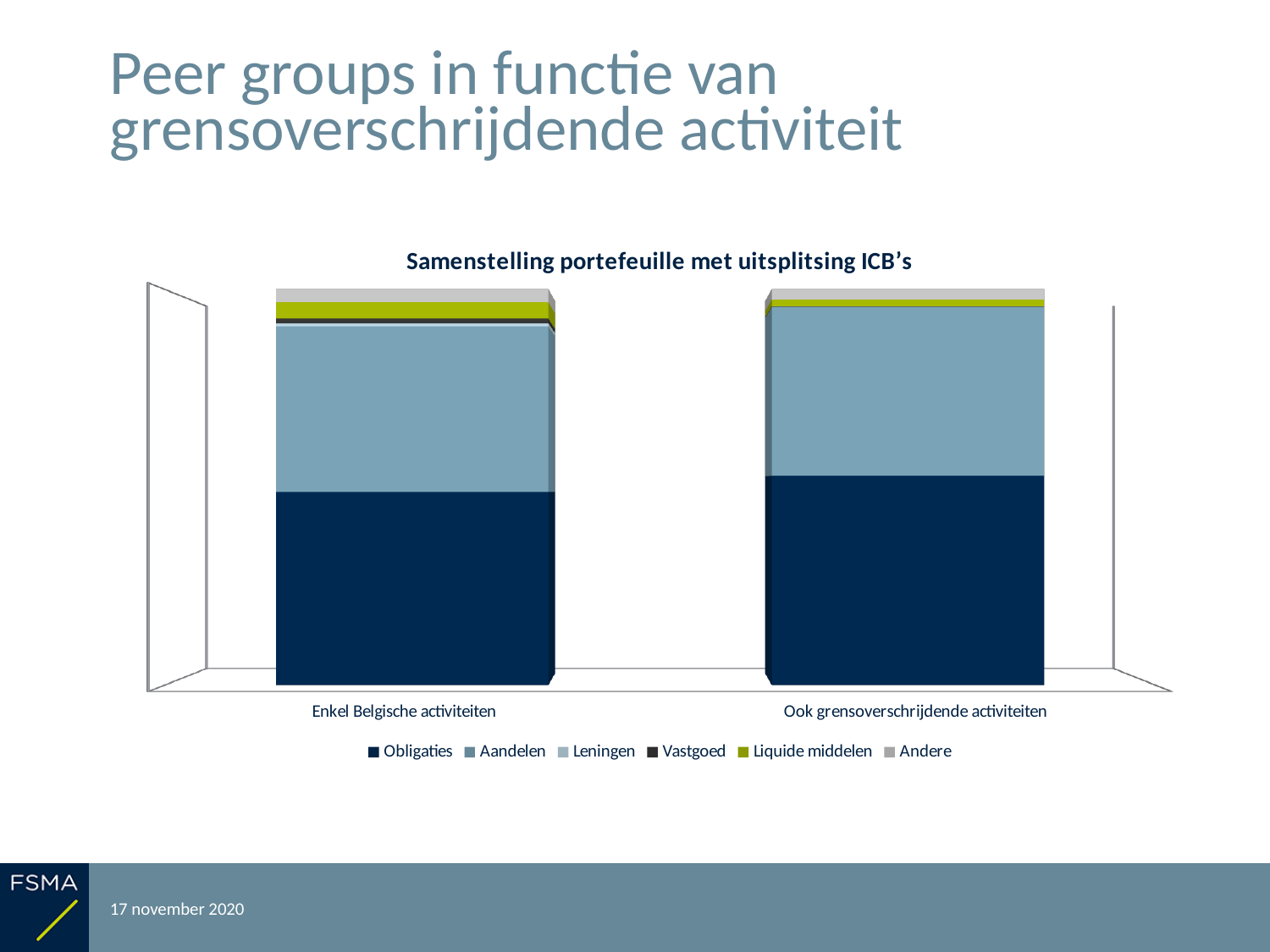
Which series makes up the largest segment of the 'Ook grensoverschrijdende activiteiten' bar? Obligaties Which bar has the larger Liquide middelen segment: 'Enkel Belgische activiteiten' or 'Ook grensoverschrijdende activiteiten'? Enkel Belgische activiteiten What is the label of the right-hand bar on the x axis? Ook grensoverschrijdende activiteiten Which series is the second-largest segment in the 'Enkel Belgische activiteiten' bar? Aandelen Which series is listed first in the chart legend? Obligaties How many categories (bars) are shown on the x axis of the chart? 2 How many series does the chart legend list? 6 What kind of chart is shown on the slide? Stacked bar chart What is the title of the chart? Samenstelling portefeuille met uitsplitsing ICB's Which bar has the larger Obligaties segment: 'Enkel Belgische activiteiten' or 'Ook grensoverschrijdende activiteiten'? Ook grensoverschrijdende activiteiten Which series makes up the largest segment of the 'Enkel Belgische activiteiten' bar? Obligaties